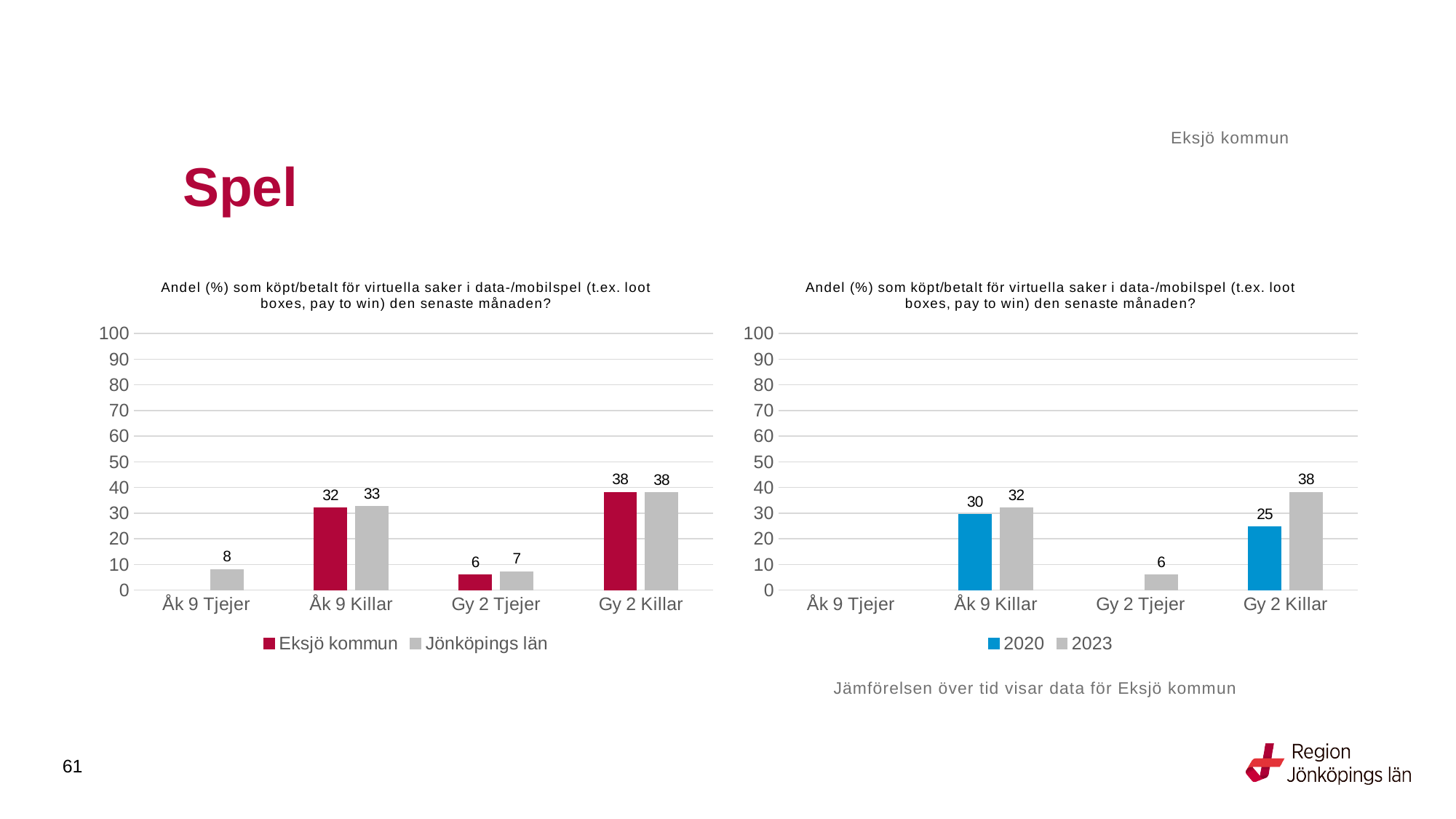
In the right chart, which category has the highest 2023 value? Gy 2 Killar In the left chart, what is the value for Eksjö kommun for Gy 2 Killar? 38 In the right chart, what is the difference between the 2023 and 2020 values for Gy 2 Killar? 13 In the left chart, what is the difference between Jönköpings län and Eksjö kommun for Åk 9 Killar? 1 In the left chart, what is the value for Jönköpings län for Åk 9 Tjejer? 8 How many categories are shown on the x axis of the right chart? 4 What kind of chart is the left chart? Bar chart In the right chart, what is the 2020 value for Gy 2 Killar? 25 In the right chart, what is the 2023 value for Gy 2 Tjejer? 6 In the left chart, how many series does the legend list? 2 In the right chart, which is larger for Åk 9 Killar, the 2020 value or the 2023 value? 2023 In the left chart, which category has the lowest value for Eksjö kommun among those with a bar shown? Gy 2 Tjejer